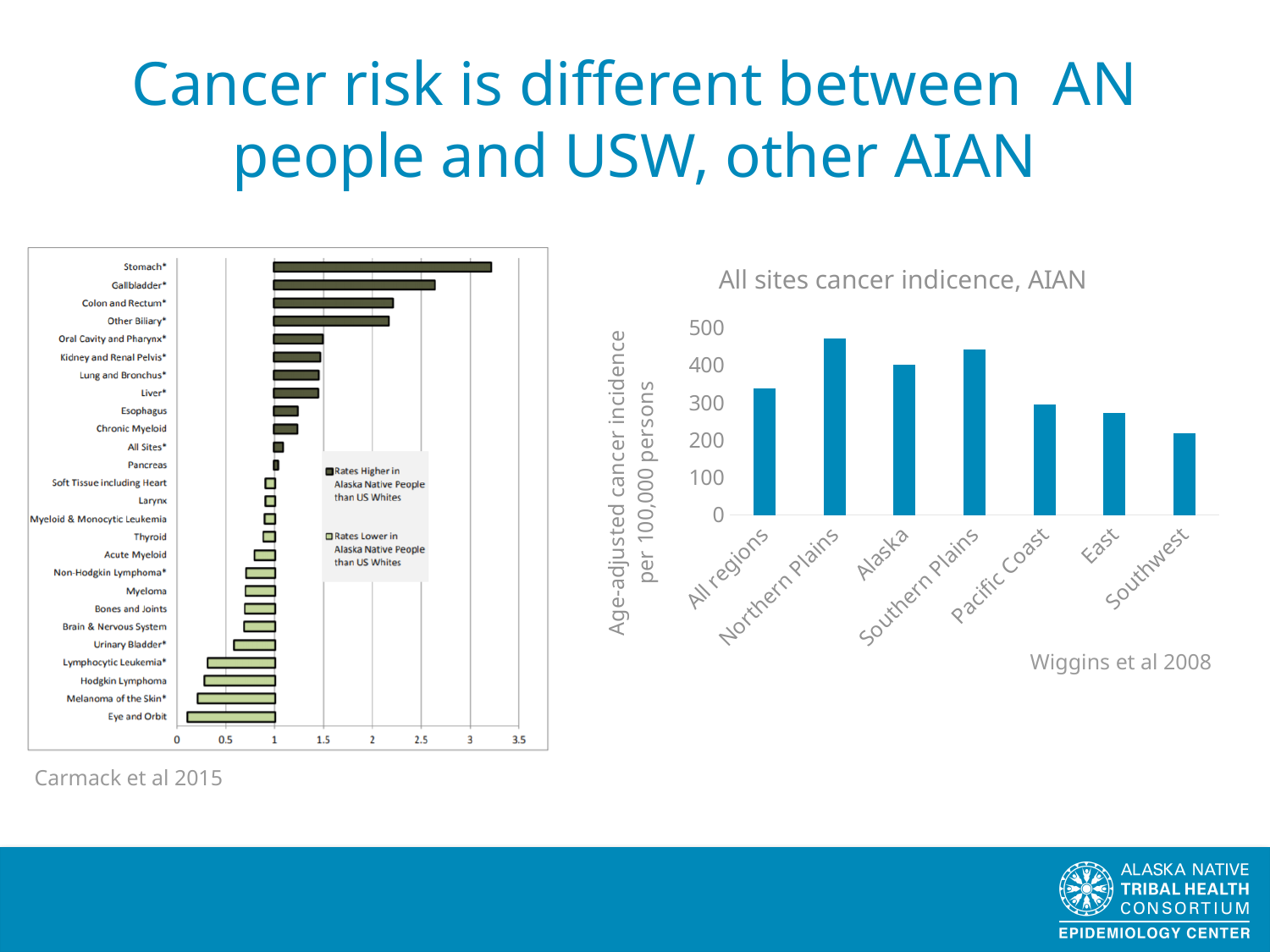
In the chart on the right, 'All sites cancer indicence, AIAN', which region has the highest incidence? Northern Plains In the chart on the right, 'All sites cancer indicence, AIAN', is the value for Northern Plains greater or less than 400? greater In the chart on the right, 'All sites cancer indicence, AIAN', is the value for East greater or less than 300? less In the chart on the right, 'All sites cancer indicence, AIAN', how many regions are plotted? 7 In the chart on the left, is the value for Stomach* greater or less than 3? greater In the chart on the left, how many series does the legend list? 2 In the chart on the right, what is the y-axis label? Age-adjusted cancer incidence per 100,000 persons In the chart on the right, 'All sites cancer indicence, AIAN', which is larger, Southern Plains or Southwest? Southern Plains In the chart on the left, which cancer site has the lowest rate ratio? Eye and Orbit What kind of chart is the chart on the right titled 'All sites cancer indicence, AIAN'? bar chart In the chart on the left, which cancer site has the highest rate ratio? Stomach* In the chart on the right, 'All sites cancer indicence, AIAN', which region has the lowest incidence? Southwest